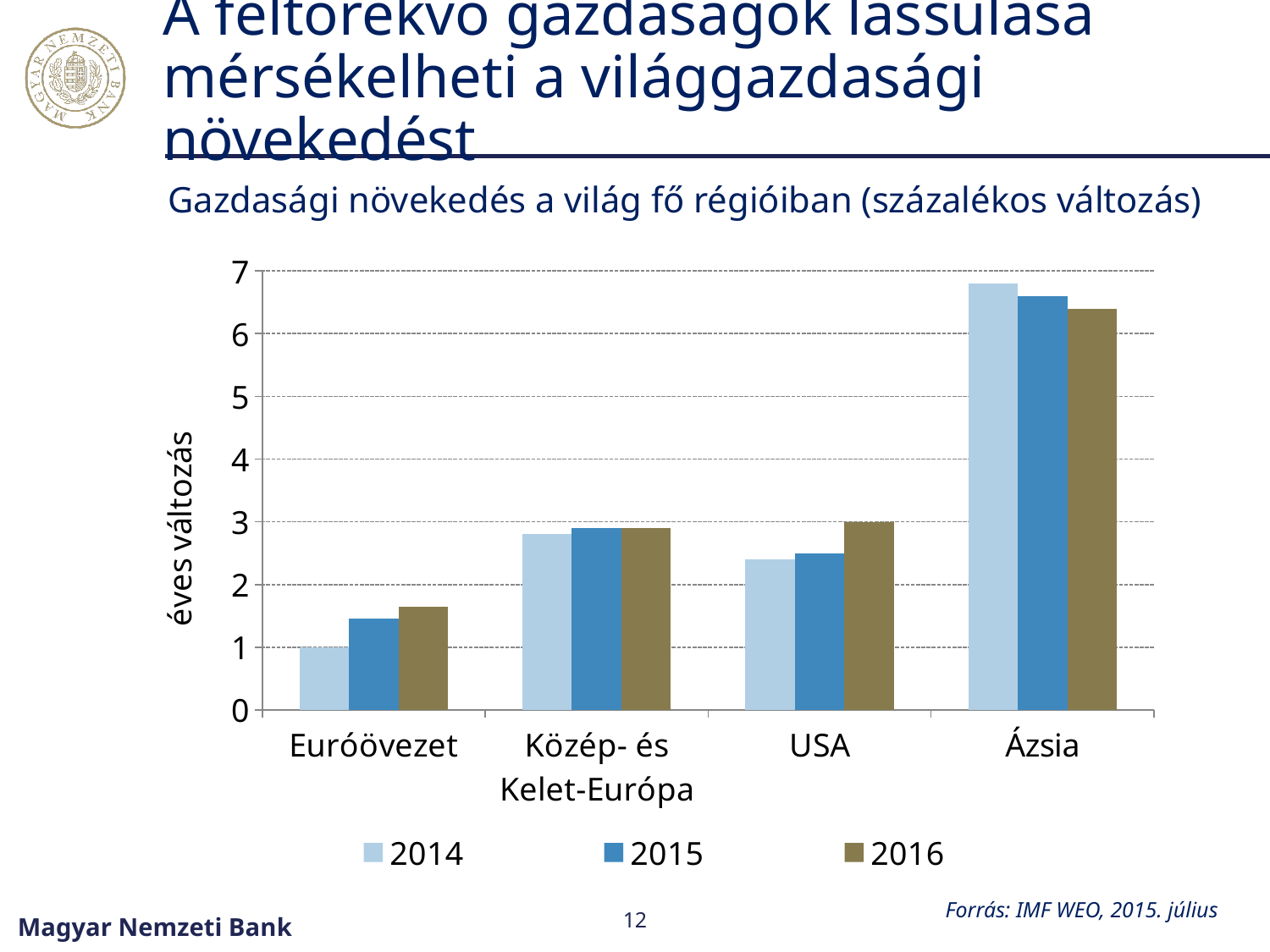
Which region has the highest value for 2015? Ázsia For Euróövezet, which is larger: the 2014 value or the 2016 value? 2016 Is the 2015 value for USA greater or less than 3? less How many series does the legend list? 3 Is the 2014 value for Ázsia greater or less than 6? greater Do the values for Ázsia rise or fall from 2014 to 2016? fall What is the label on the vertical axis of the chart? éves változás How many regions are shown on the x axis? 4 Which region has the lowest value for 2014? Euróövezet Do the values for Euróövezet rise or fall from 2014 to 2016? rise Is the 2014 value for Közép- és Kelet-Európa greater or less than 2? greater What kind of chart is shown on the slide? bar chart